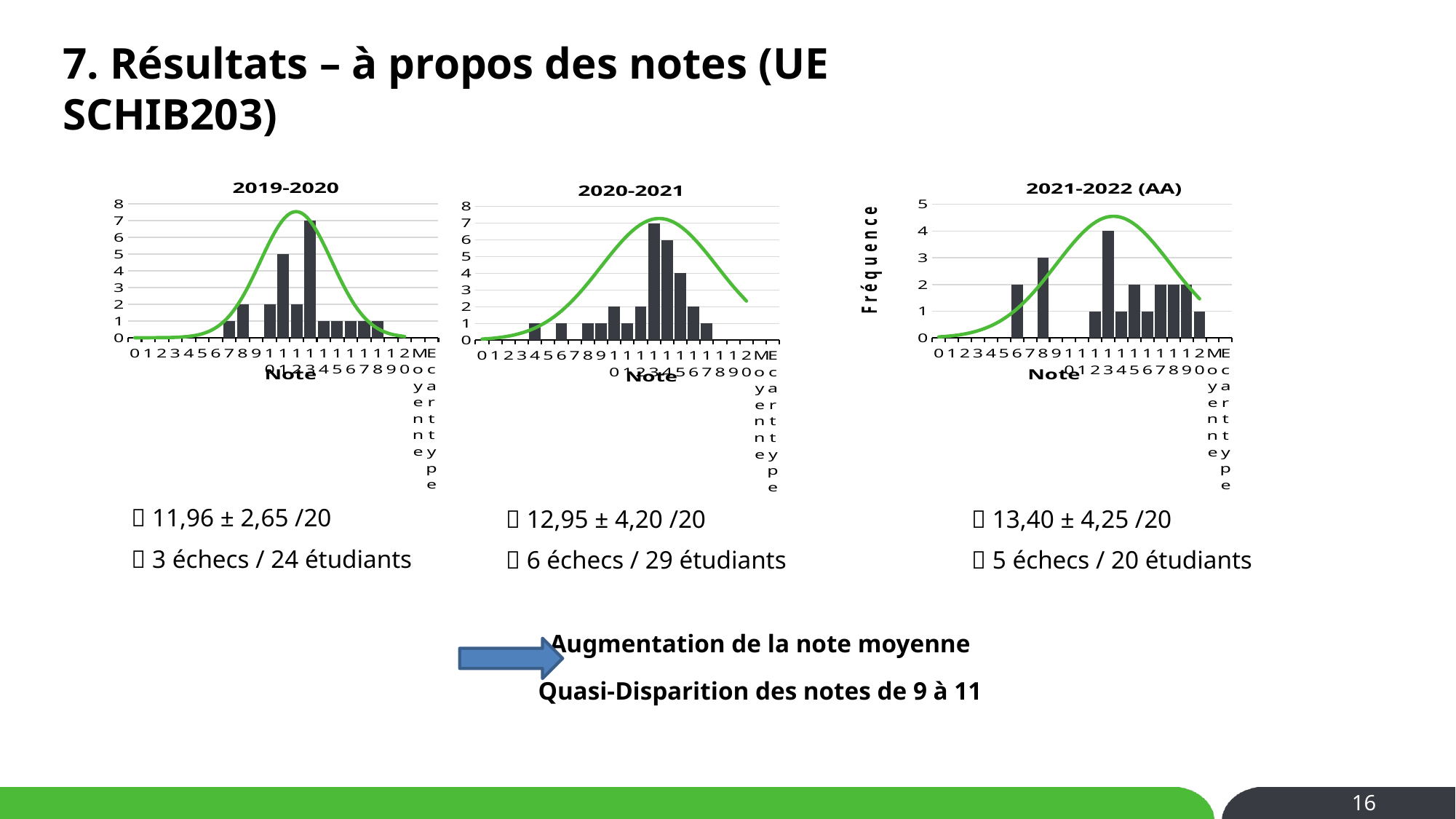
In the 2021-2022 (AA) chart, what is the highest frequency reached by any bar? 4 Which chart has the lower peak bar, 2019-2020 or 2021-2022 (AA)? 2021-2022 (AA) What kind of chart is the 2019-2020 chart? combination bar and line chart In the 2019-2020 chart, which note has the highest frequency? 13 What is the title of the vertical axis on the 2021-2022 (AA) chart? Fréquence In the 2019-2020 chart, what is the frequency for note 11? 5 In the 2021-2022 (AA) chart, what is the frequency for note 8? 3 In the 2020-2021 chart, what is the highest frequency reached by any bar? 7 In the 2019-2020 chart, what is the frequency for note 13? 7 In the 2019-2020 chart, is the tallest bar greater or less than 6? greater How many charts are shown on the slide? 3 What is the title of the horizontal axis on the 2020-2021 chart? Note